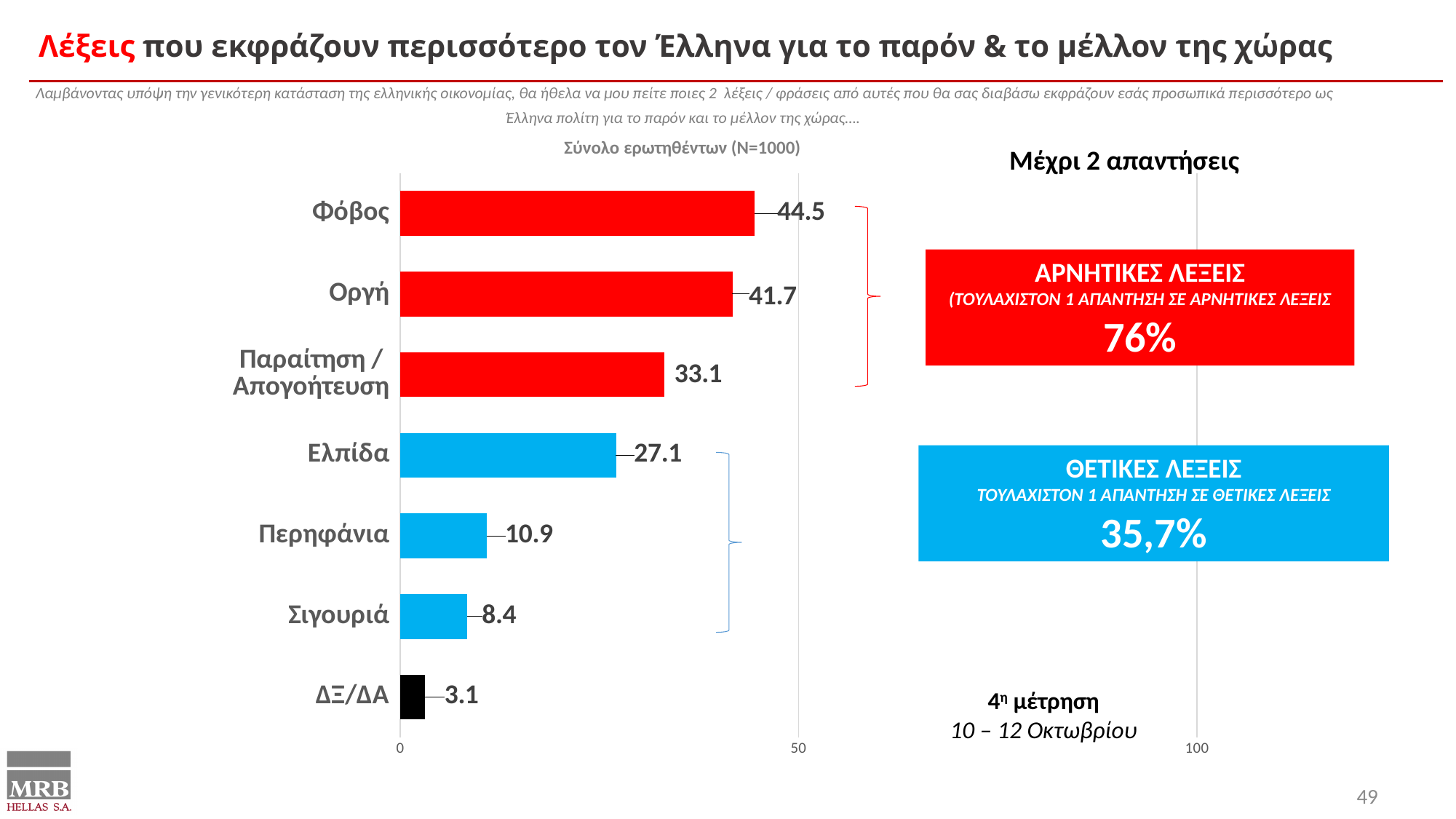
Which category has the highest value? Φόβος What is the difference between the values for Ελπίδα and Περηφάνια? 16.2 What is the value for Σιγουριά? 8.4 What is the value for Ελπίδα? 27.1 Which category has the lowest value? ΔΞ/ΔΑ What percentage is shown in the red box for ΑΡΝΗΤΙΚΕΣ ΛΕΞΕΙΣ? 76% What kind of chart is shown on the slide? bar chart Is the value for Οργή greater or less than 50? less How many categories are shown in the bar chart? 7 What is the value for Φόβος? 44.5 Which is larger, the value for Παραίτηση / Απογοήτευση or the value for Ελπίδα? Παραίτηση / Απογοήτευση What is the difference between the values for Φόβος and Οργή? 2.8